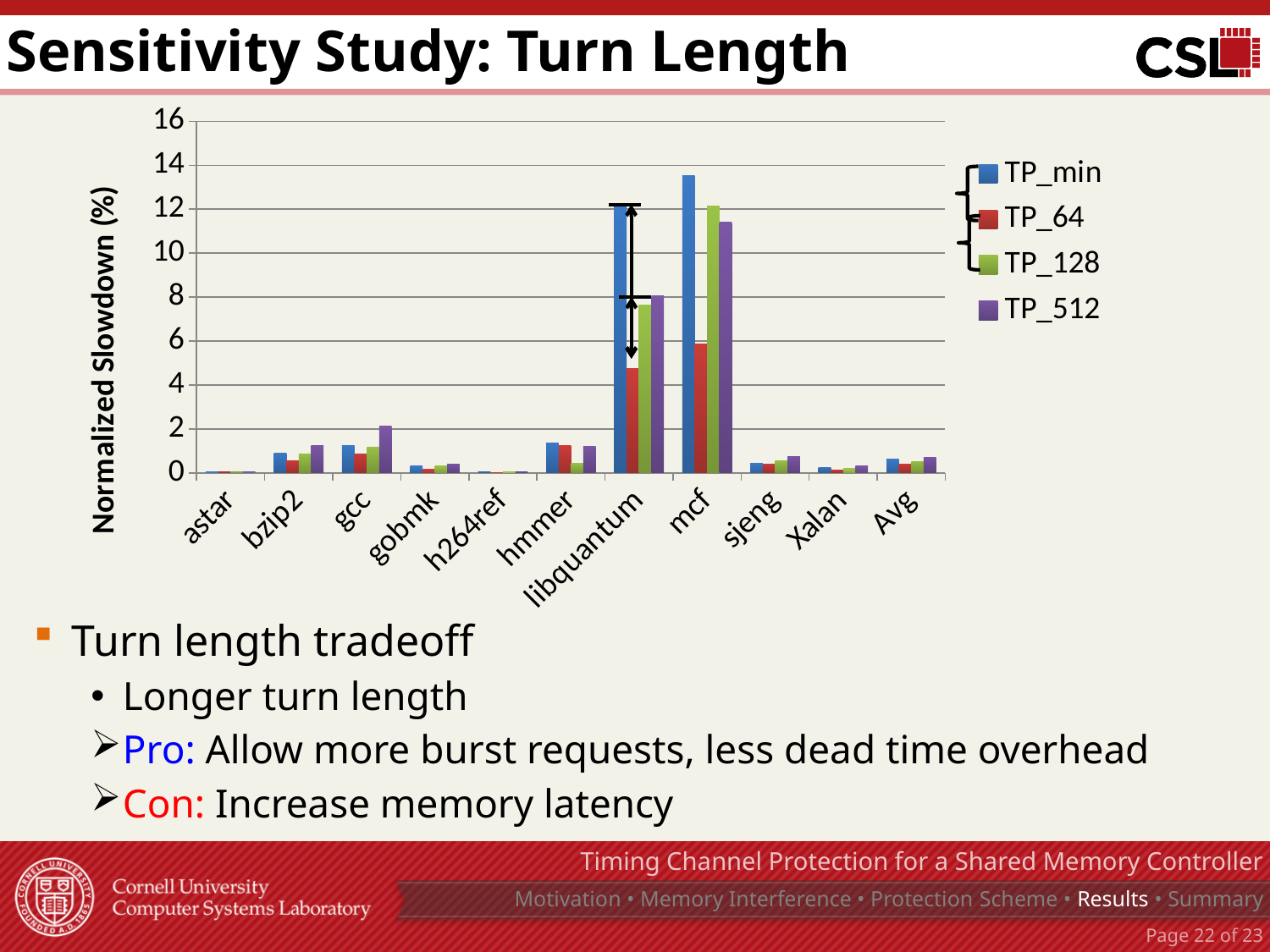
Is the TP_min value for libquantum greater or less than 10? greater Which is larger, the TP_min value for mcf or the TP_min value for libquantum? mcf What is the label of the y axis? Normalized Slowdown (%) How many categories are shown on the x axis? 11 Is the TP_64 value for mcf greater or less than 8? less Is the TP_min value for mcf greater or less than 12? greater How many series does the legend list? 4 Which category has the highest TP_min value? mcf What kind of chart is shown on the slide? bar chart For libquantum, which is larger, the TP_64 value or the TP_128 value? TP_128